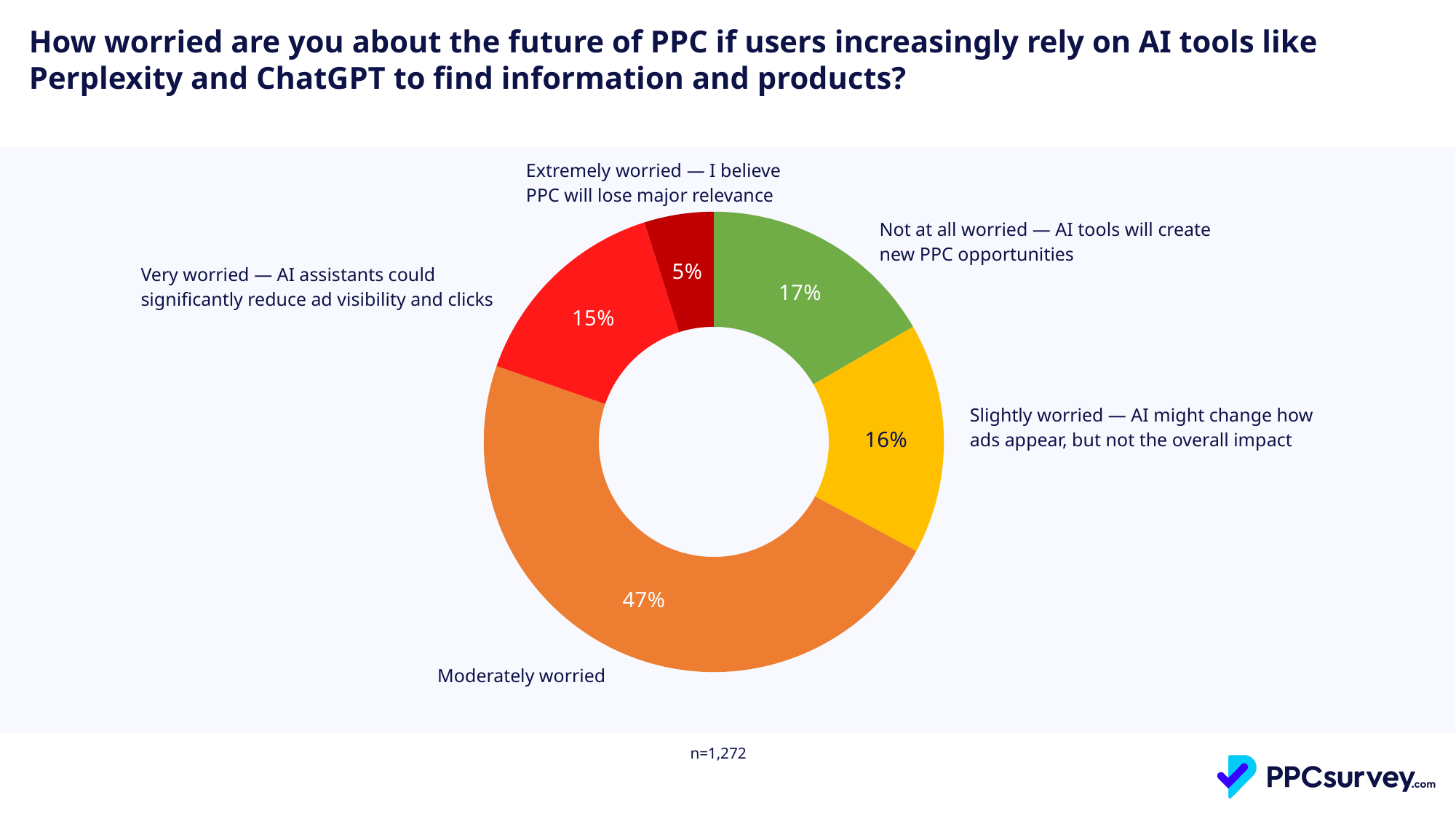
What type of chart is shown on the slide? Donut chart What percentage of respondents are not at all worried? 17% Which share is larger: not at all worried or very worried? Not at all worried What is the difference in percentage points between the moderately worried and slightly worried shares? 31 What is the sample size shown below the chart? n=1,272 What percentage of respondents are extremely worried? 5% What percentage of respondents are very worried? 15% Which response category has the largest share? Moderately worried What colour is the slice for slightly worried? Yellow What percentage of respondents are moderately worried? 47% Which response category has the smallest share? Extremely worried How many response categories are shown in the chart? 5